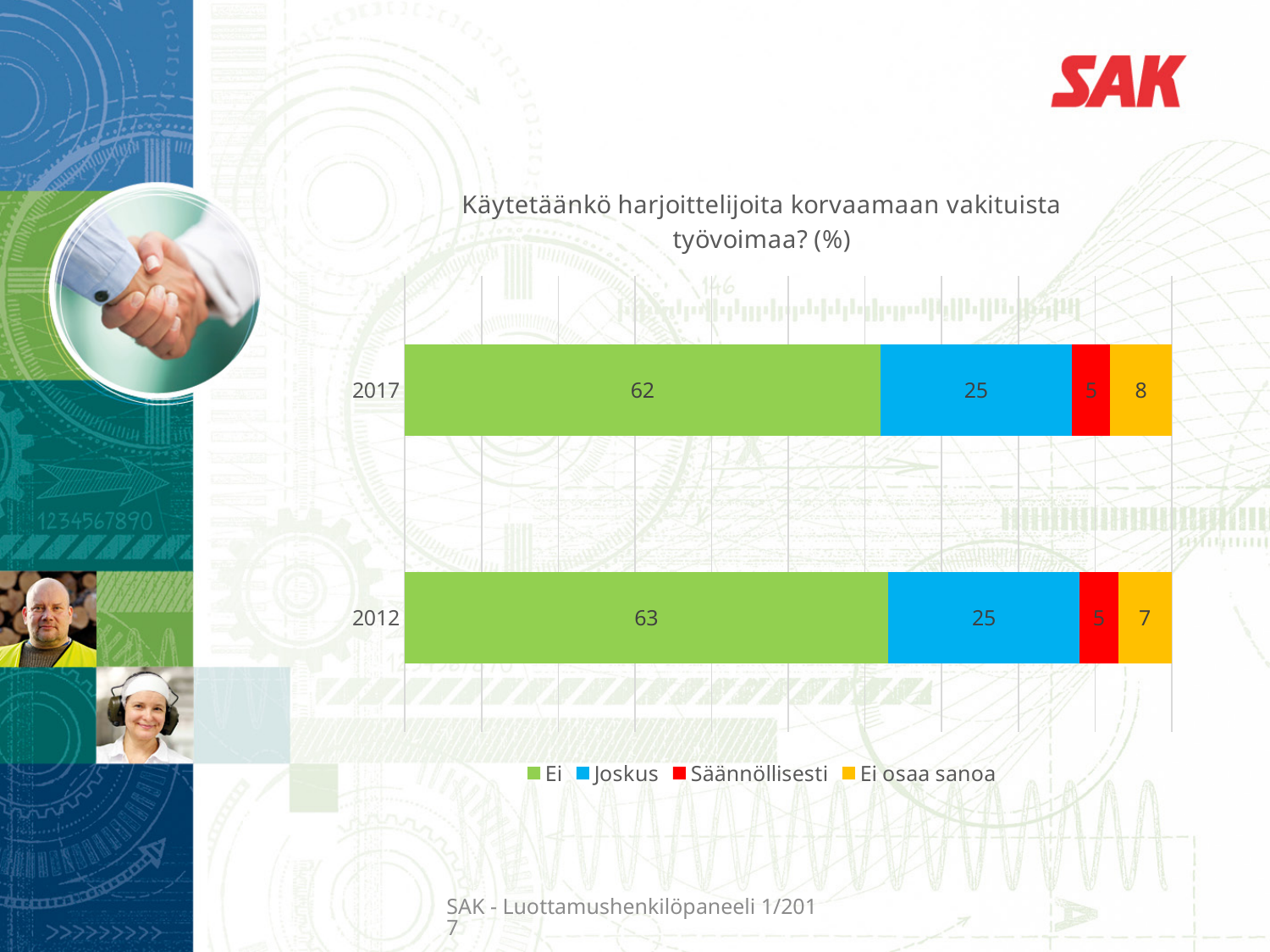
What is the difference between the "Ei" values for 2012 and 2017? 1 How many series does the legend list? 4 Which series has the highest value in 2012? Ei What is the total of the stacked bar for 2017? 100 How many categories (years) are shown on the chart? 2 What is the value for "Ei" in 2017? 62 What is the value for "Ei osaa sanoa" in 2017? 8 What kind of chart is shown on the slide? Stacked bar chart What is the value for "Joskus" in 2012? 25 Which series has the lowest value in 2017? Säännöllisesti What is the value for "Säännöllisesti" in 2012? 5 Is the "Ei osaa sanoa" value larger in 2017 or in 2012? 2017